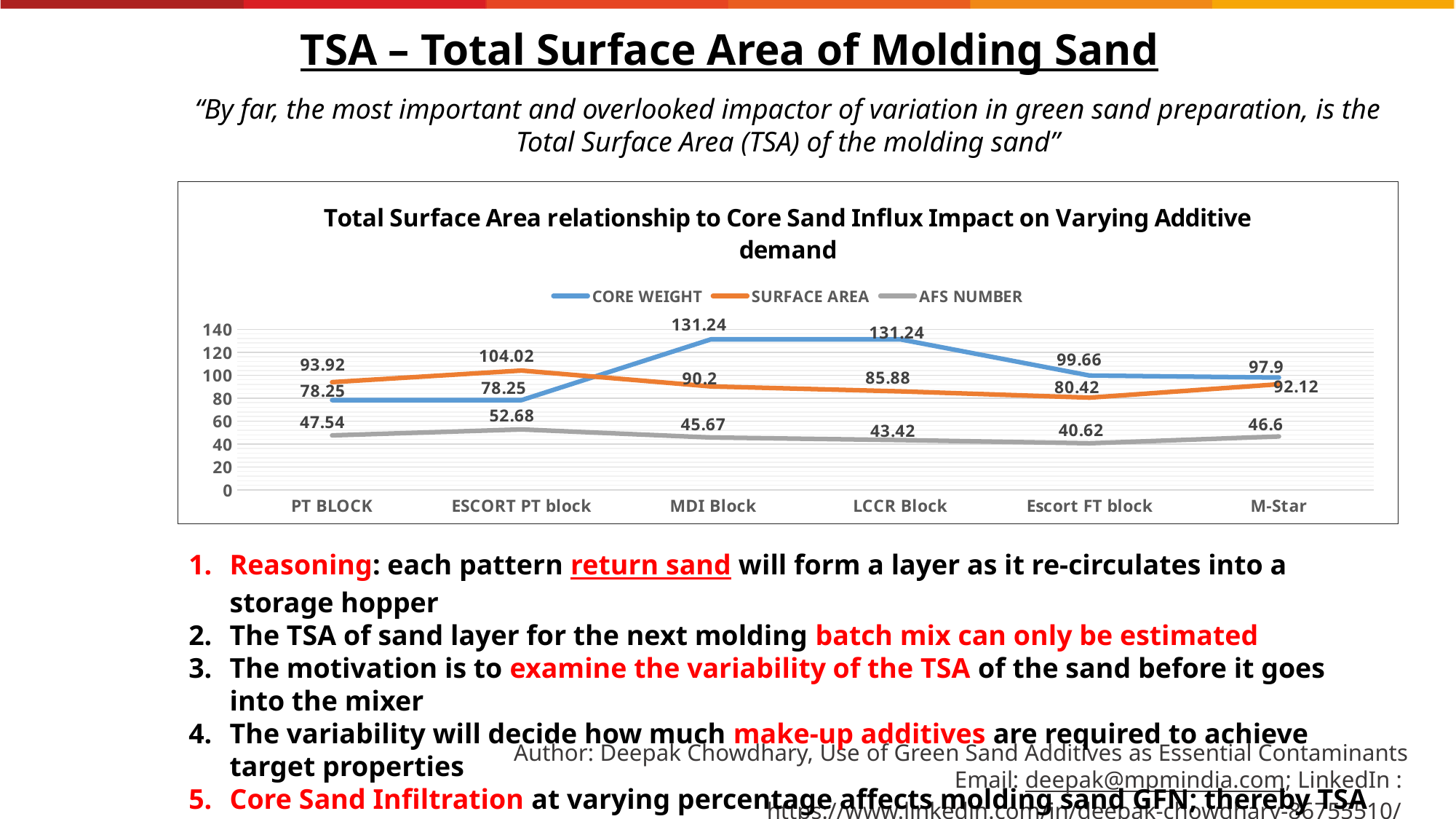
What is the AFS NUMBER value for Escort FT block? 40.62 What is the CORE WEIGHT value for MDI Block? 131.24 How many series does the legend list? 3 Which category has the highest SURFACE AREA value? ESCORT PT block What is the title of the chart? Total Surface Area relationship to Core Sand Influx Impact on Varying Additive demand What is the difference between the CORE WEIGHT values for MDI Block and PT BLOCK? 52.99 Which is larger for M-Star, CORE WEIGHT or SURFACE AREA? CORE WEIGHT Which category has the lowest AFS NUMBER value? Escort FT block What is the SURFACE AREA value for ESCORT PT block? 104.02 How many categories are shown on the x axis? 6 What type of chart is shown on the slide? Line chart Does the SURFACE AREA series rise or fall from ESCORT PT block to Escort FT block? Fall